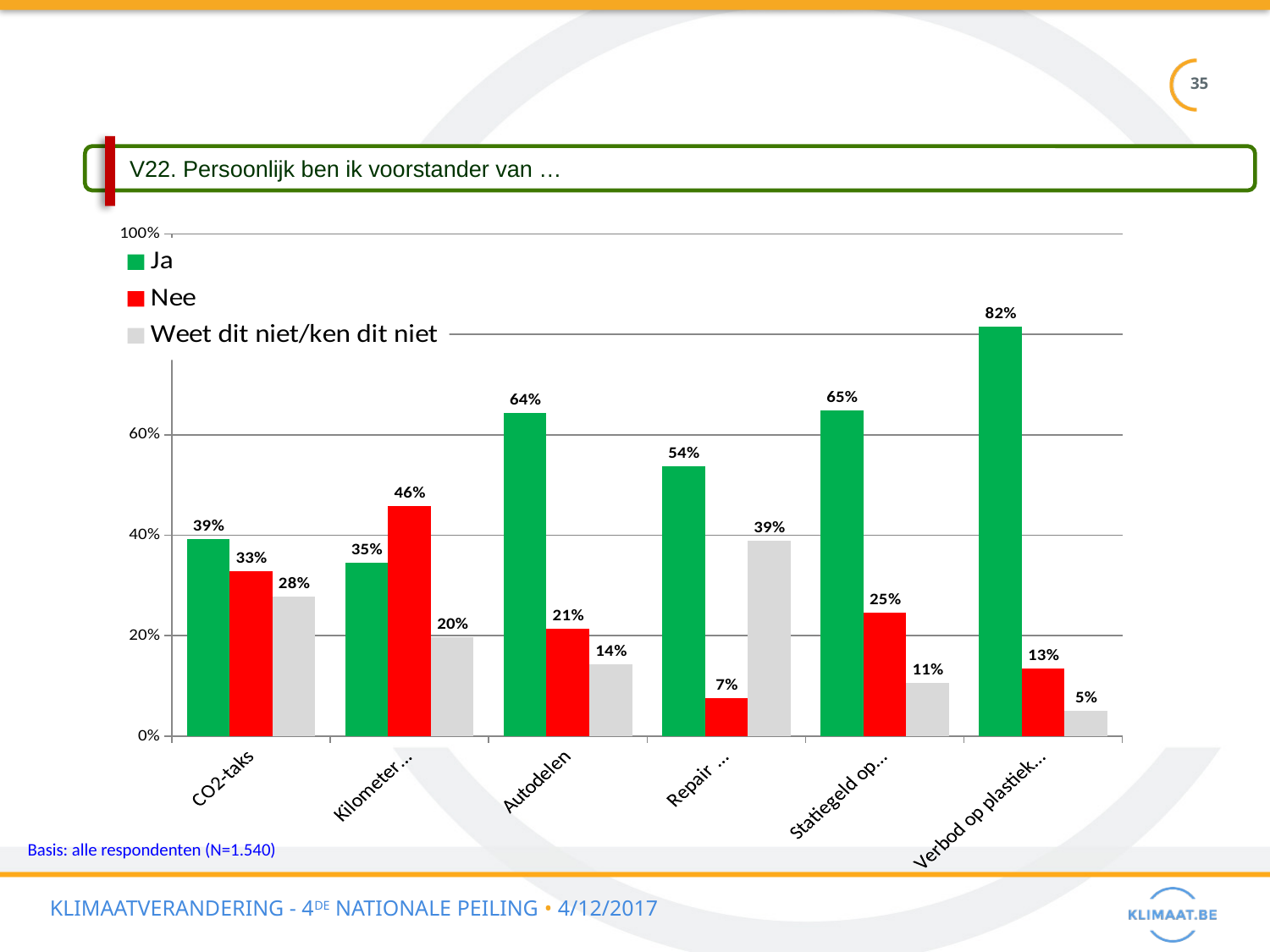
How many series does the legend list? 3 Which colour represents the 'Nee' series? Red Which category has the highest 'Ja' value? Verbod op plastiek… Is the 'Ja' value for Repair … greater or less than 40%? greater For Kilometer…, which is larger: the 'Ja' value or the 'Nee' value? Nee What is the 'Weet dit niet/ken dit niet' value for Repair …? 39% What is the difference between the 'Ja' and 'Nee' values for Statiegeld op…? 40% What is the 'Ja' value for Autodelen? 64% What is the 'Nee' value for CO2-taks? 33% How many categories are shown on the x axis? 6 What kind of chart is shown on the slide? Bar chart Which category has the lowest 'Nee' value? Repair …